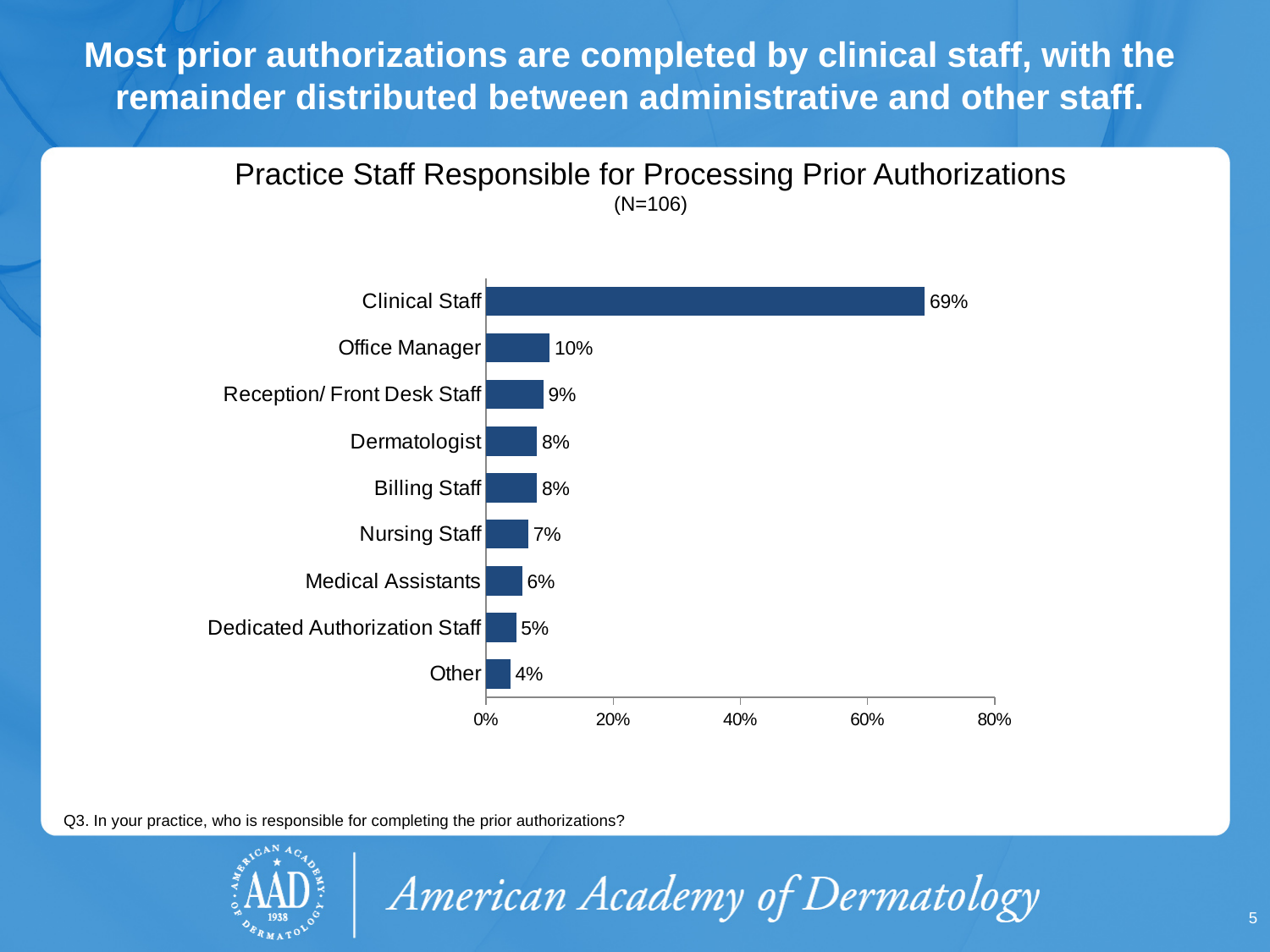
What is the value shown for Office Manager? 10% Is the value for Clinical Staff greater or less than 60%? greater Which category has the highest value in the chart? Clinical Staff Which has a larger value, Medical Assistants or Nursing Staff? Nursing Staff What kind of chart is shown on the slide? Bar chart What is the difference between the values for Clinical Staff and Office Manager? 59% What is the difference between the values for Reception/ Front Desk Staff and Nursing Staff? 2% Which category has the lowest value in the chart? Other What is the value shown for Dedicated Authorization Staff? 5% What is the sample size (N) stated under the chart title? N=106 How many categories are shown in the chart? 9 What percentage of practices report that Clinical Staff are responsible for processing prior authorizations? 69%